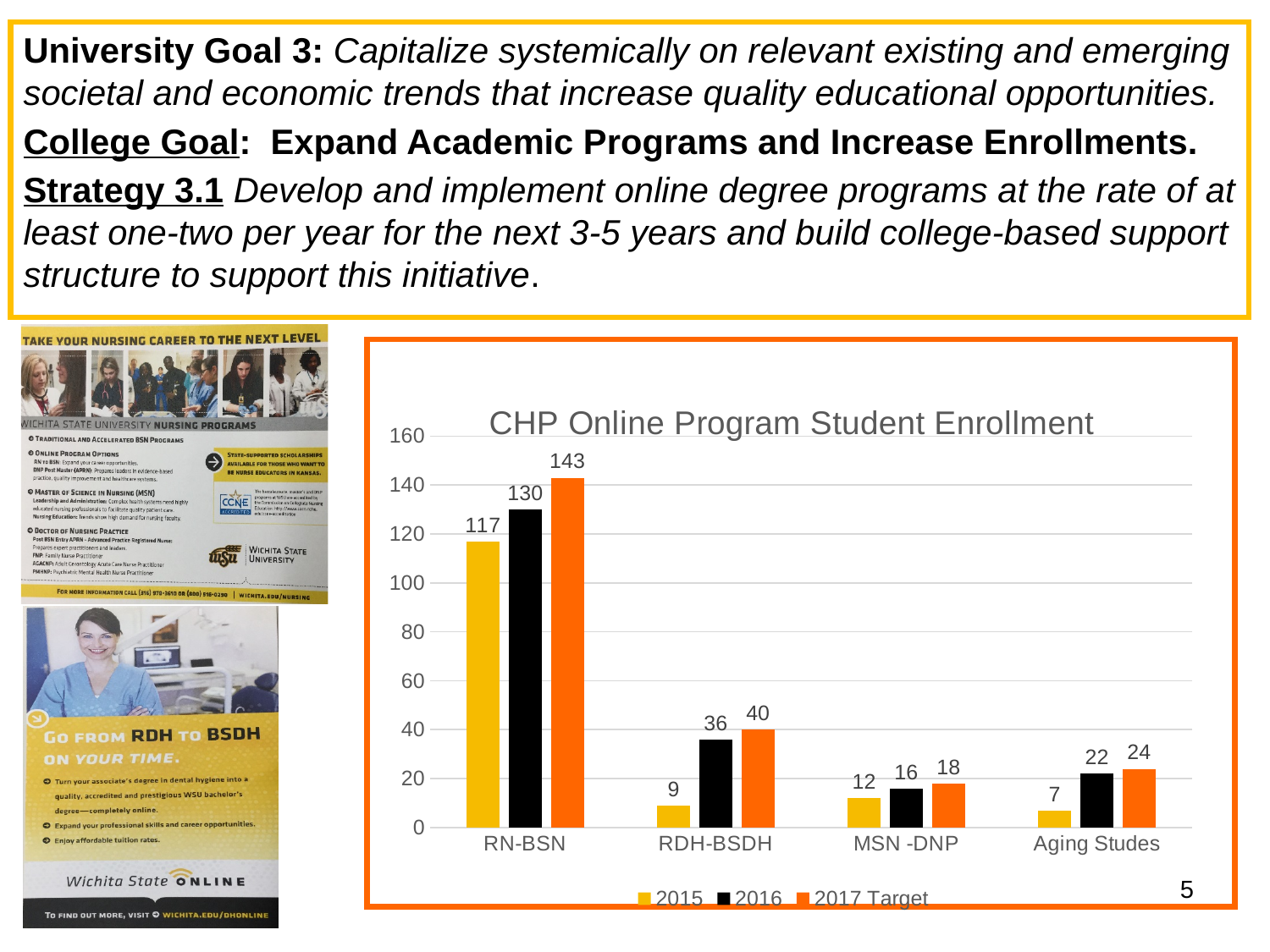
Is the 2016 value for RN-BSN greater or less than 120? greater What is the difference between the 2017 Target and the 2015 value for RN-BSN? 26 How many series does the legend list? 3 What kind of chart is the CHP Online Program Student Enrollment chart? bar chart What is the 2016 enrollment for RN-BSN in the CHP Online Program Student Enrollment chart? 130 Which is larger for MSN -DNP: the 2015 value or the 2016 value? 2016 Which program has the highest 2017 Target enrollment? RN-BSN Which program has the lowest 2015 enrollment? Aging Studes How many programs are shown on the x axis of the chart? 4 For RDH-BSDH, do the values rise or fall from 2015 to 2017 Target? rise What is the 2017 Target value for RDH-BSDH? 40 What is the 2015 enrollment for Aging Studes? 7